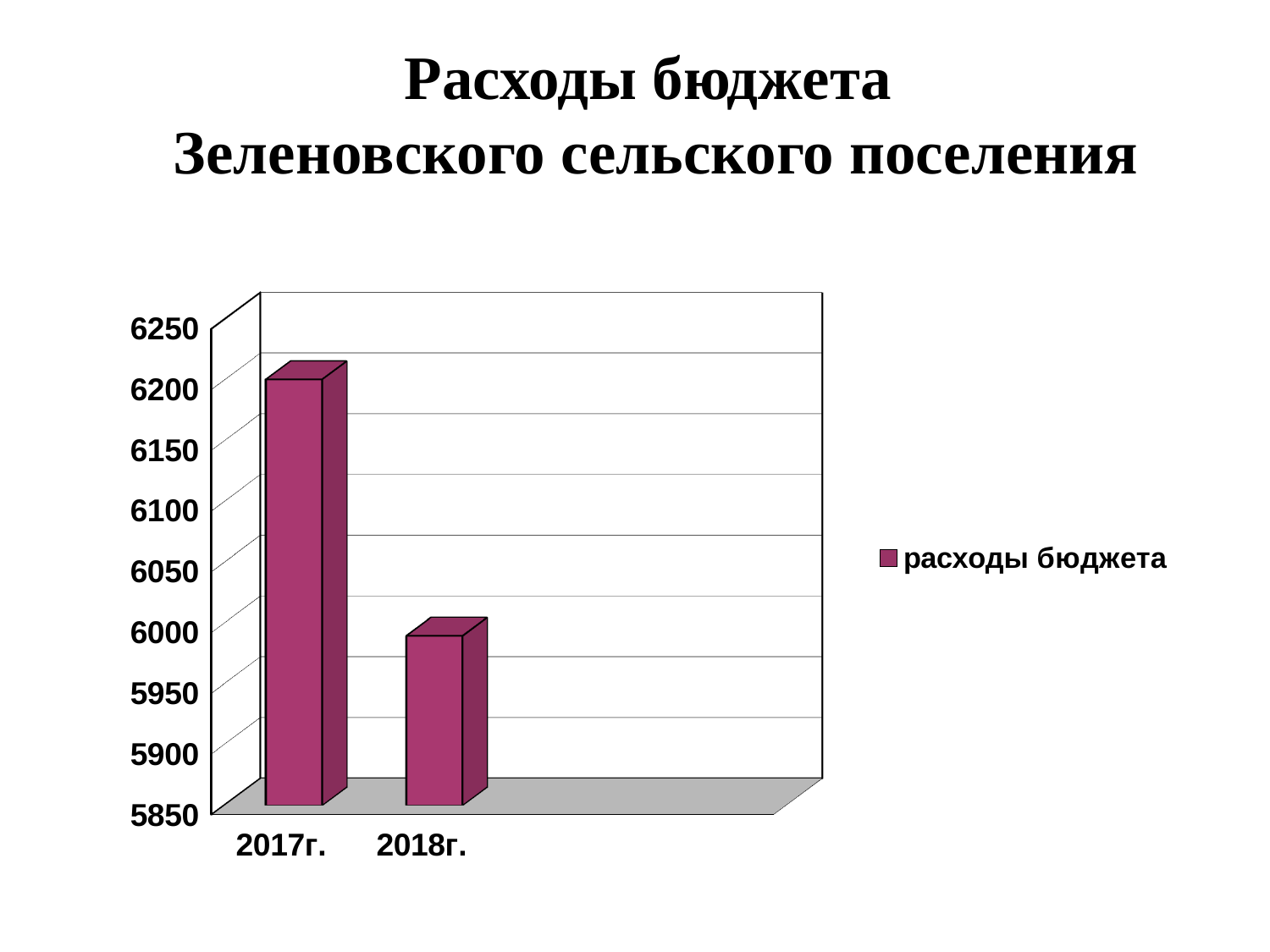
Which year has the highest value for расходы бюджета? 2017г. Is the value for 2018г. greater or less than 5900? greater How many categories are shown on the x axis of the chart? 2 Is the value for 2017г. greater or less than 6100? greater What kind of chart is shown on the slide? bar chart Which is larger, the value for 2017г. or the value for 2018г.? 2017г. What series name is shown in the chart legend? расходы бюджета How many series does the chart legend list? 1 Do the values rise or fall from 2017г. to 2018г.? fall What is the title of the slide's chart? Расходы бюджета Зеленовского сельского поселения Which year has the lowest value for расходы бюджета? 2018г. Is the value for 2018г. greater or less than 6100? less